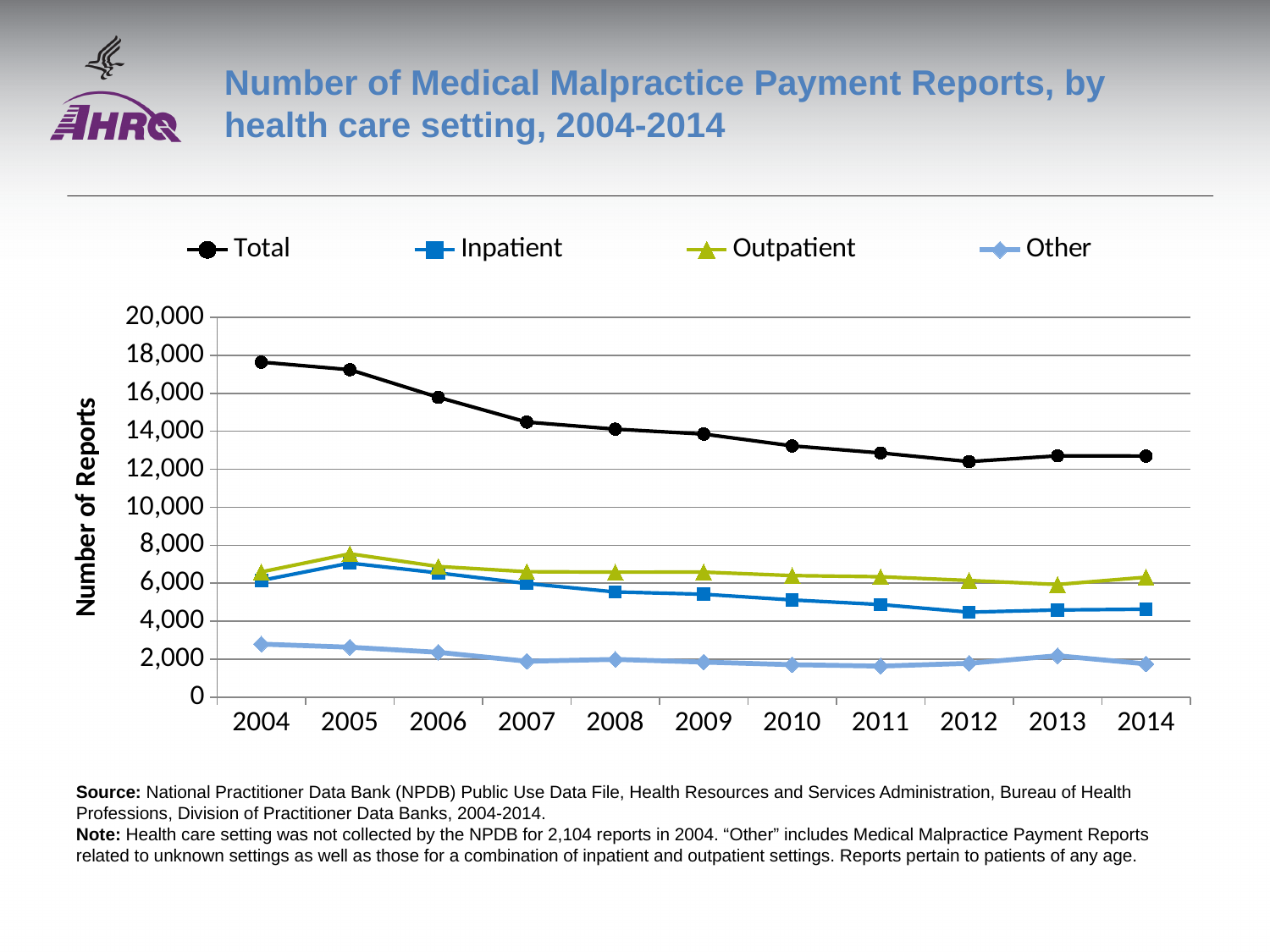
Is the value for Total in 2014 greater or less than 14,000? less Does the Total series rise or fall from 2004 to 2014? fall Is the value for Total in 2004 greater or less than 16,000? greater Which series has the lowest values across all years? Other In 2012, which is larger, Inpatient or Outpatient? Outpatient How many years are plotted along the x axis? 11 What is the label on the y axis? Number of Reports What kind of chart is shown on the slide? line chart How many series does the legend list? 4 Is the value for Other in 2004 greater or less than 2,000? greater In which year is the Total series highest? 2004